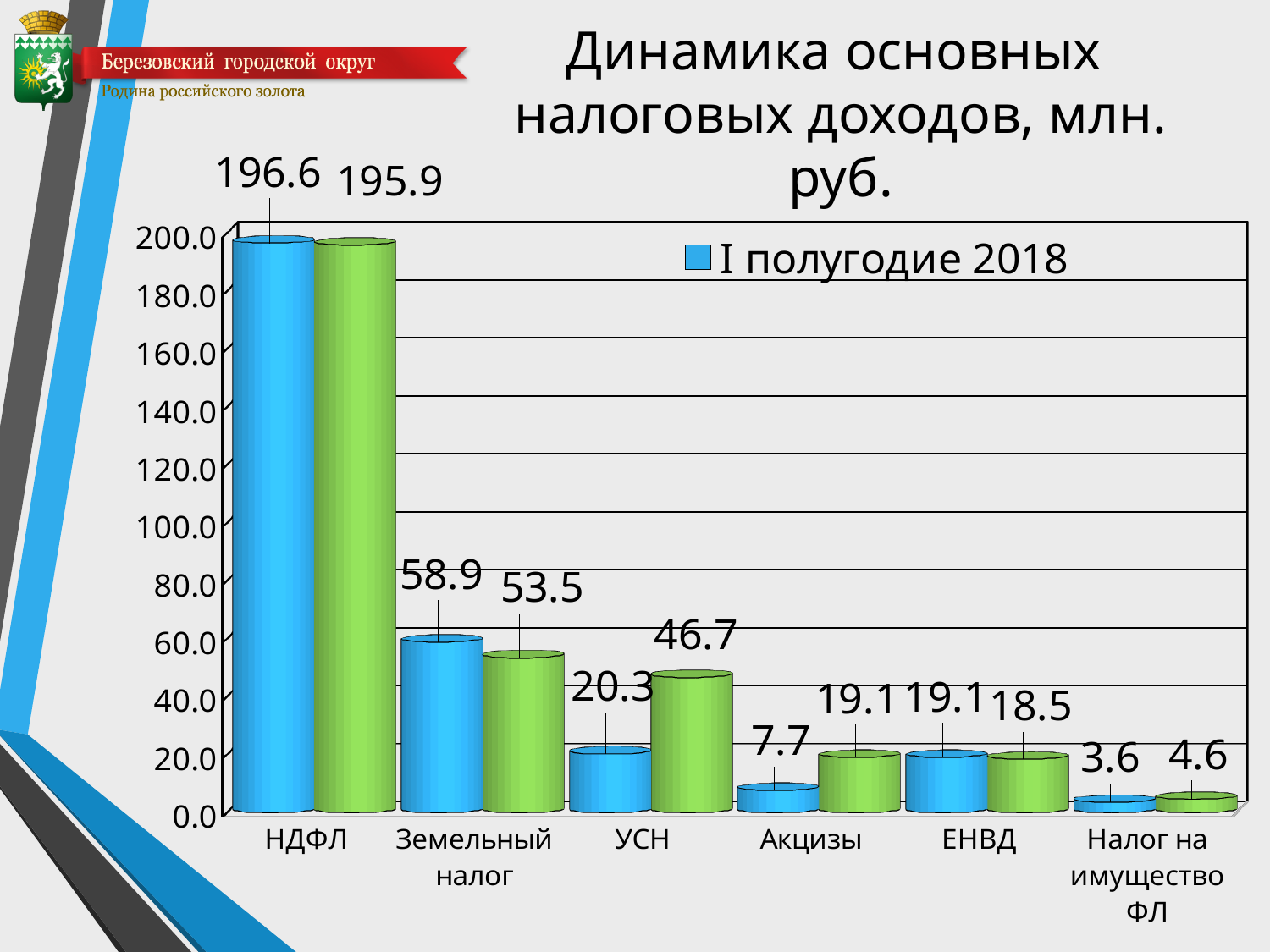
For УСН, what is the difference between the green bar value (46.7) and the I полугодие 2018 value (20.3)? 26.4 What is the title of the chart? Динамика основных налоговых доходов, млн. руб. What is the value shown on the green bar for УСН? 46.7 Which category has the lowest value in the I полугодие 2018 series? Налог на имущество ФЛ How many categories are shown on the x axis of the chart? 6 For Акцизы, which bar is larger: the blue I полугодие 2018 bar or the green bar? the green bar Is the I полугодие 2018 value for Земельный налог greater or less than 40.0? greater What type of chart is shown on the slide? bar chart Which category has the highest value in the I полугодие 2018 series? НДФЛ For Земельный налог, how much larger is the I полугодие 2018 value (58.9) than the green bar value (53.5)? 5.4 What is the value for НДФЛ in the I полугодие 2018 series? 196.6 What is the value shown on the green bar for ЕНВД? 18.5